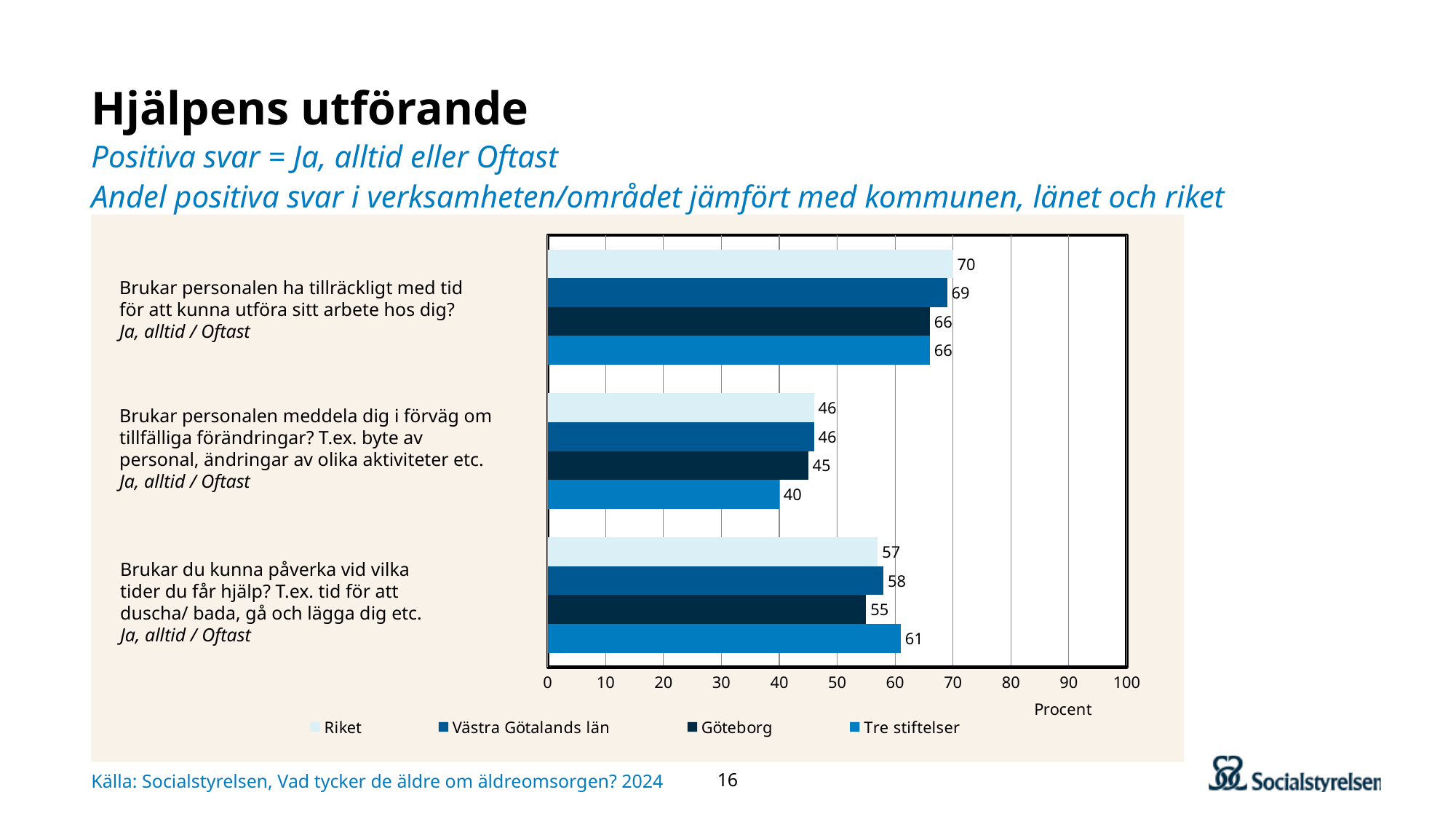
How many series does the legend list? 4 What unit label is shown under the x axis of the chart? Procent What is the value for Tre stiftelser on the question 'Brukar personalen meddela dig i förväg om tillfälliga förändringar?' 40 Which series has the lowest value on the question 'Brukar personalen meddela dig i förväg om tillfälliga förändringar?' Tre stiftelser What is the value for Västra Götalands län on the question 'Brukar du kunna påverka vid vilka tider du får hjälp?' 58 What kind of chart is shown on the slide? bar chart What is the value for Riket on the question 'Brukar personalen ha tillräckligt med tid för att kunna utföra sitt arbete hos dig?' 70 What is the difference between the Riket value and the Tre stiftelser value on the question 'Brukar personalen ha tillräckligt med tid för att kunna utföra sitt arbete hos dig?' 4 What is the value for Göteborg on the question 'Brukar du kunna påverka vid vilka tider du får hjälp?' 55 Which series has the highest value on the question 'Brukar du kunna påverka vid vilka tider du får hjälp?' Tre stiftelser Which is larger for Tre stiftelser: the value on 'Brukar du kunna påverka vid vilka tider du får hjälp?' or the value on 'Brukar personalen meddela dig i förväg om tillfälliga förändringar?' Brukar du kunna påverka vid vilka tider du får hjälp? How many question categories are plotted in the chart? 3